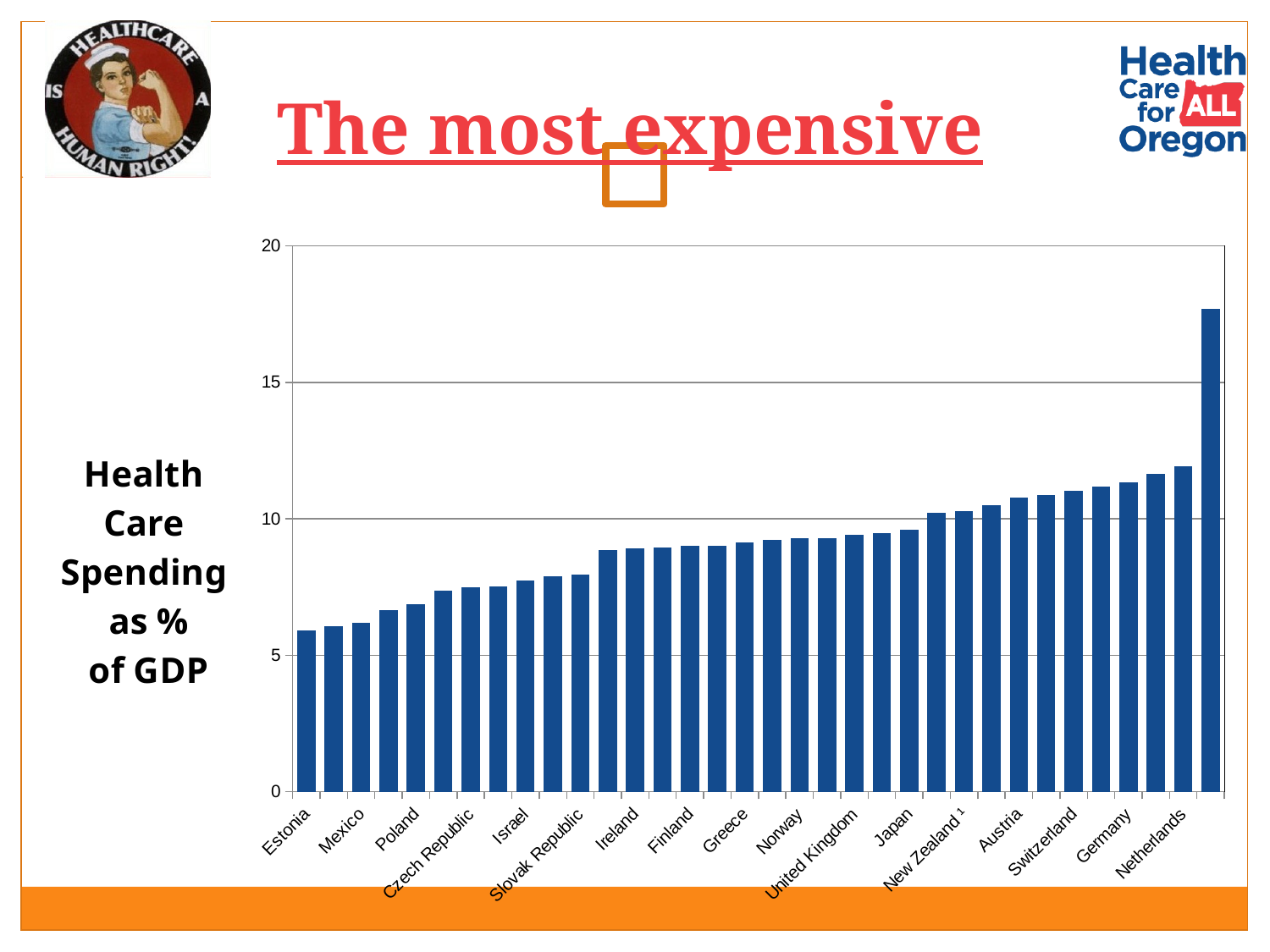
Is the value for Ireland greater or less than 10? less Is the value for Japan greater or less than 10? less Which of the labeled countries has the highest value? Netherlands Is the value for Estonia greater or less than 5? greater Which of the labeled countries has the lowest value? Estonia What kind of chart is shown on the slide? bar chart Do the values rise or fall moving from left to right along the x axis? rise What quantity does the chart plot, according to the label to the left of the chart? Health Care Spending as % of GDP Which has the larger value, Germany or Japan? Germany What is the title of the slide containing the chart? The most expensive